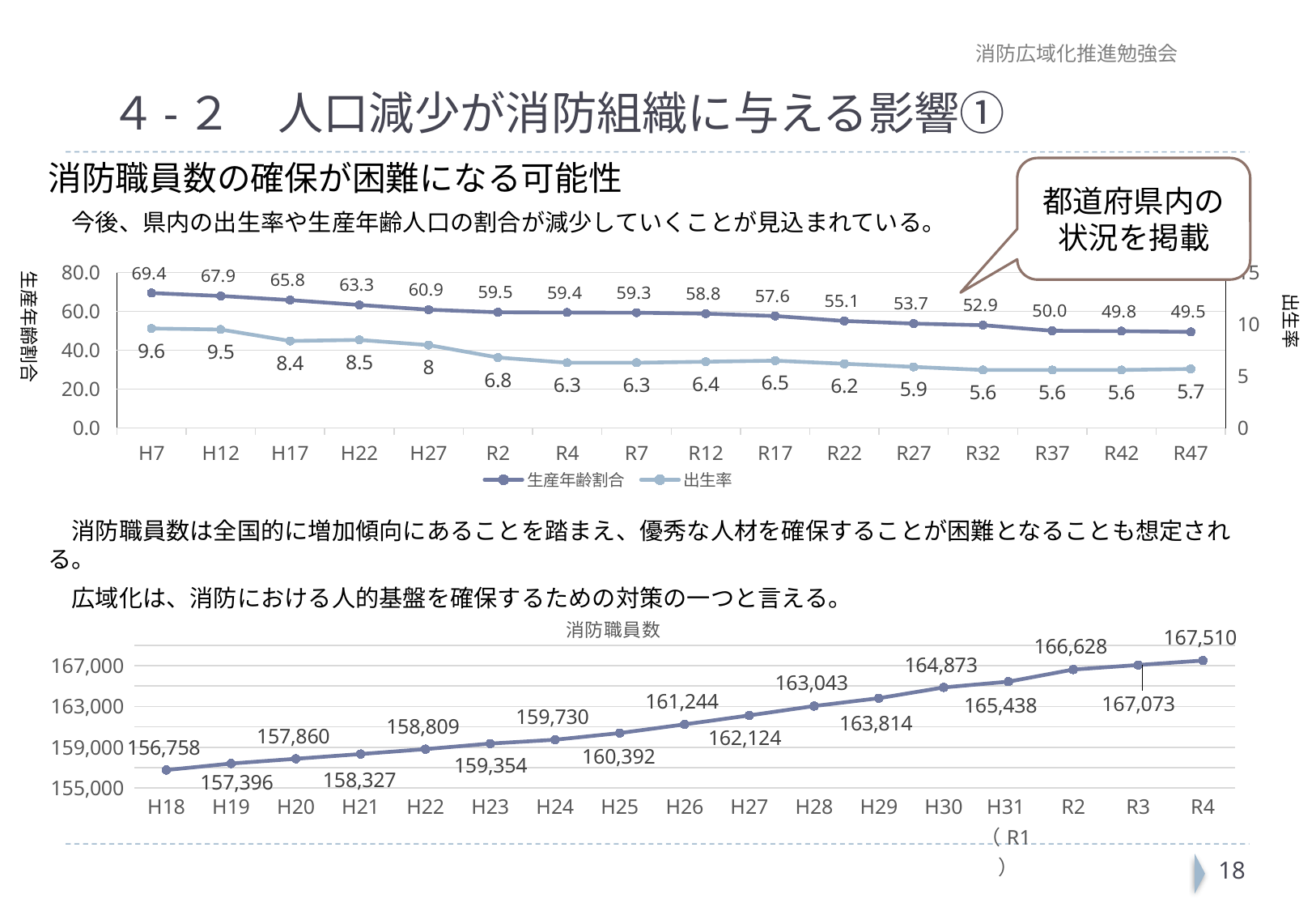
In the bottom chart titled 消防職員数, what is the difference between the values for R4 and H18? 10,752 In the bottom chart titled 消防職員数, which category has the highest value? R4 In the top chart, which category has the lowest 出生率 value? R32, R37, R42 (5.6) In the bottom chart titled 消防職員数, what is the value for H28? 163,043 In the top chart, how many series does the legend list? 2 In the top chart, does the 生産年齢割合 series rise or fall from H7 to R47? fall In the bottom chart titled 消防職員数, how many data points are plotted? 17 In the top chart, what is the difference between the 生産年齢割合 values for H7 and R47? 19.9 What type of chart is the bottom chart titled 消防職員数? line chart In the top chart, what is the value of 生産年齢割合 for H7? 69.4 In the top chart, what is the value of 出生率 for R2? 6.8 In the bottom chart titled 消防職員数, which category has the lowest value? H18